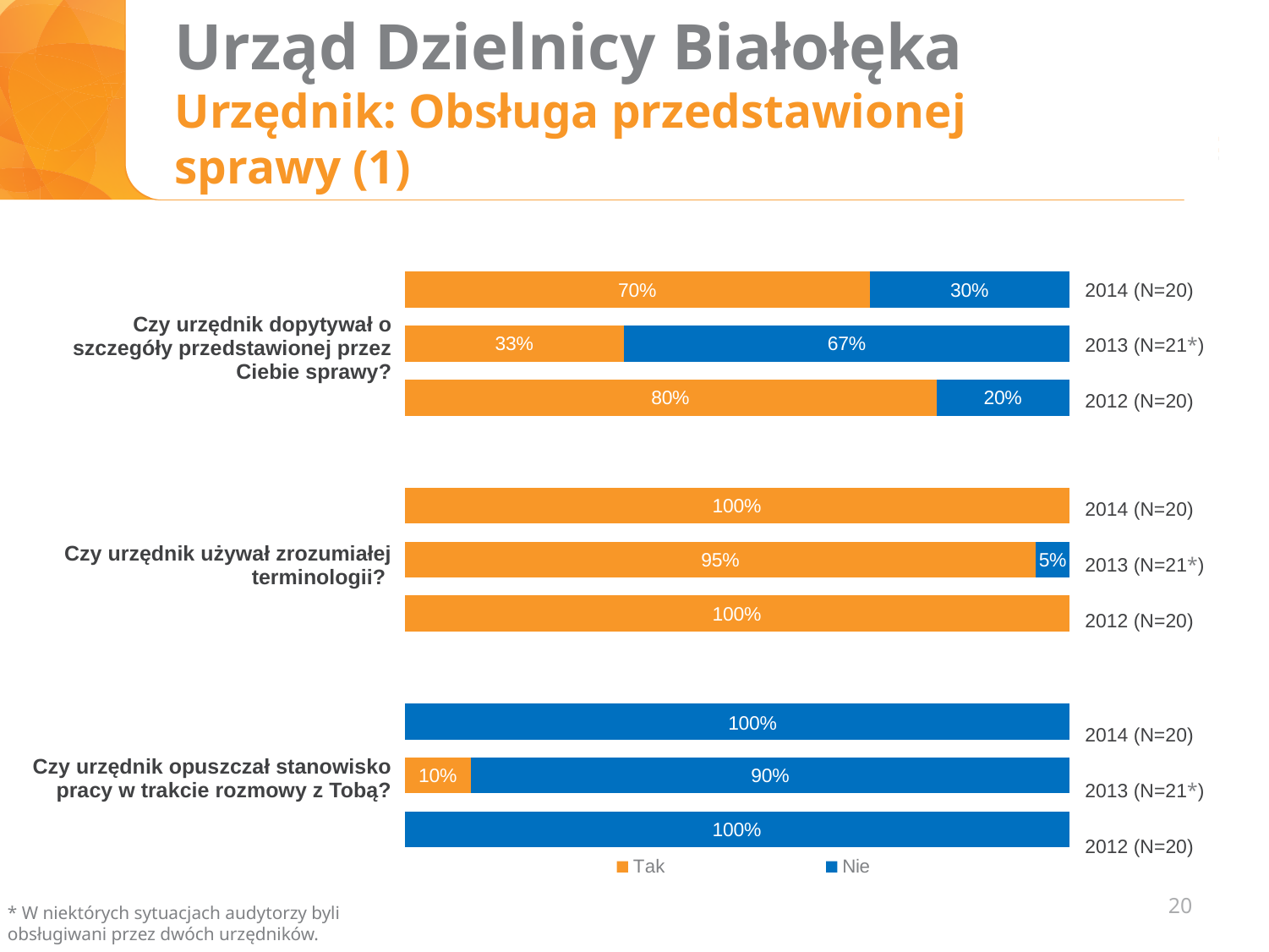
What kind of chart is shown on the slide? Stacked bar chart What share of respondents answered "Nie" in 2013 to the question "Czy urzędnik dopytywał o szczegóły przedstawionej przez Ciebie sprawy?"? 67% For the question "Czy urzędnik dopytywał o szczegóły przedstawionej przez Ciebie sprawy?" in 2013, which answer was larger, "Tak" or "Nie"? Nie For the question "Czy urzędnik dopytywał o szczegóły przedstawionej przez Ciebie sprawy?", which year had the highest "Tak" share? 2012 What share of respondents answered "Tak" in 2013 to the question "Czy urzędnik używał zrozumiałej terminologii?"? 95% What is the total of the stacked bar for 2014 for the question "Czy urzędnik dopytywał o szczegóły przedstawionej przez Ciebie sprawy?"? 100% What share of respondents answered "Tak" in 2013 to the question "Czy urzędnik opuszczał stanowisko pracy w trakcie rozmowy z Tobą?"? 10% For the question "Czy urzędnik dopytywał o szczegóły przedstawionej przez Ciebie sprawy?", what is the difference between the "Tak" share in 2012 and in 2014? 10 percentage points Which colour represents the "Nie" answer in the chart? Blue For the question "Czy urzędnik dopytywał o szczegóły przedstawionej przez Ciebie sprawy?", which year had the lowest "Tak" share? 2013 How many series does the legend list? 2 What share of respondents answered "Tak" in 2014 to the question "Czy urzędnik dopytywał o szczegóły przedstawionej przez Ciebie sprawy?"? 70%